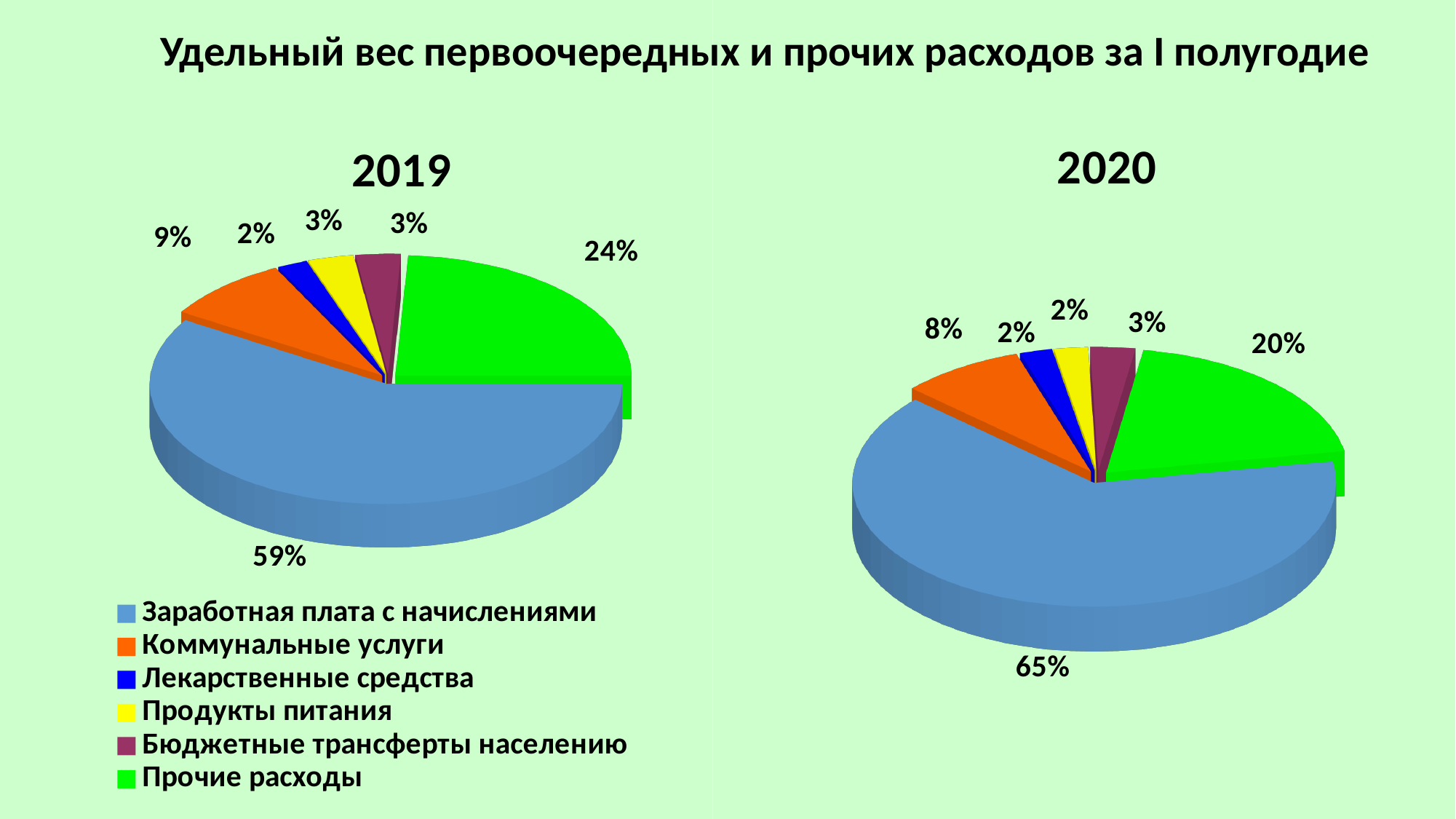
In the 2019 pie chart, which category has the smallest share? Лекарственные средства In the 2019 pie chart, what is the share for Заработная плата с начислениями? 59% Which colour represents Прочие расходы in the legend? Green By how many percentage points does the share of Прочие расходы in 2019 exceed that in 2020? 4 In the 2019 pie chart, what is the share for Коммунальные услуги? 9% In the 2020 pie chart, what is the share for Заработная плата с начислениями? 65% In the 2019 pie chart, what is the share for Прочие расходы? 24% In the 2020 pie chart, what is the share for Коммунальные услуги? 8% In the 2020 pie chart, which category has the largest share? Заработная плата с начислениями What type of chart is used for 2019 and 2020? Pie chart Which is larger: the share of Заработная плата с начислениями in 2019 or in 2020? 2020 How many categories does the legend list? 6